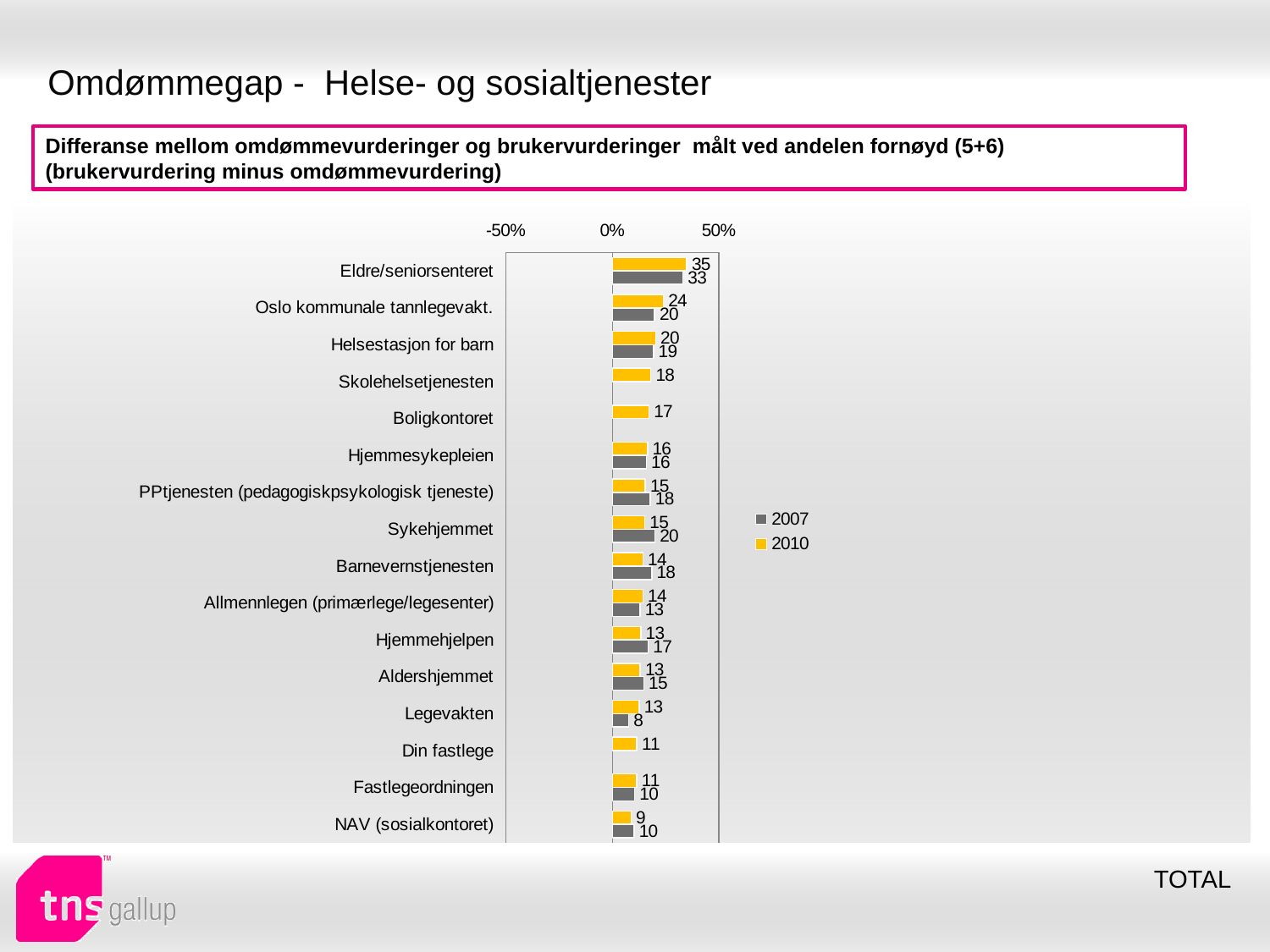
What is the 2007 value for Legevakten? 8 How many categories are shown on the chart? 16 What is the 2010 value for Eldre/seniorsenteret? 35 Which category has the lowest 2010 value? NAV (sosialkontoret) Which category has the highest 2010 value? Eldre/seniorsenteret Which is larger for Hjemmehjelpen, the 2007 value or the 2010 value? 2007 Which colour represents the 2010 series in the chart? Yellow What is the 2007 value for Sykehjemmet? 20 What is the difference between the 2010 and 2007 values for Oslo kommunale tannlegevakt.? 4 What kind of chart is shown on the slide? Bar chart How many series does the legend list? 2 What is the 2010 value for Boligkontoret? 17